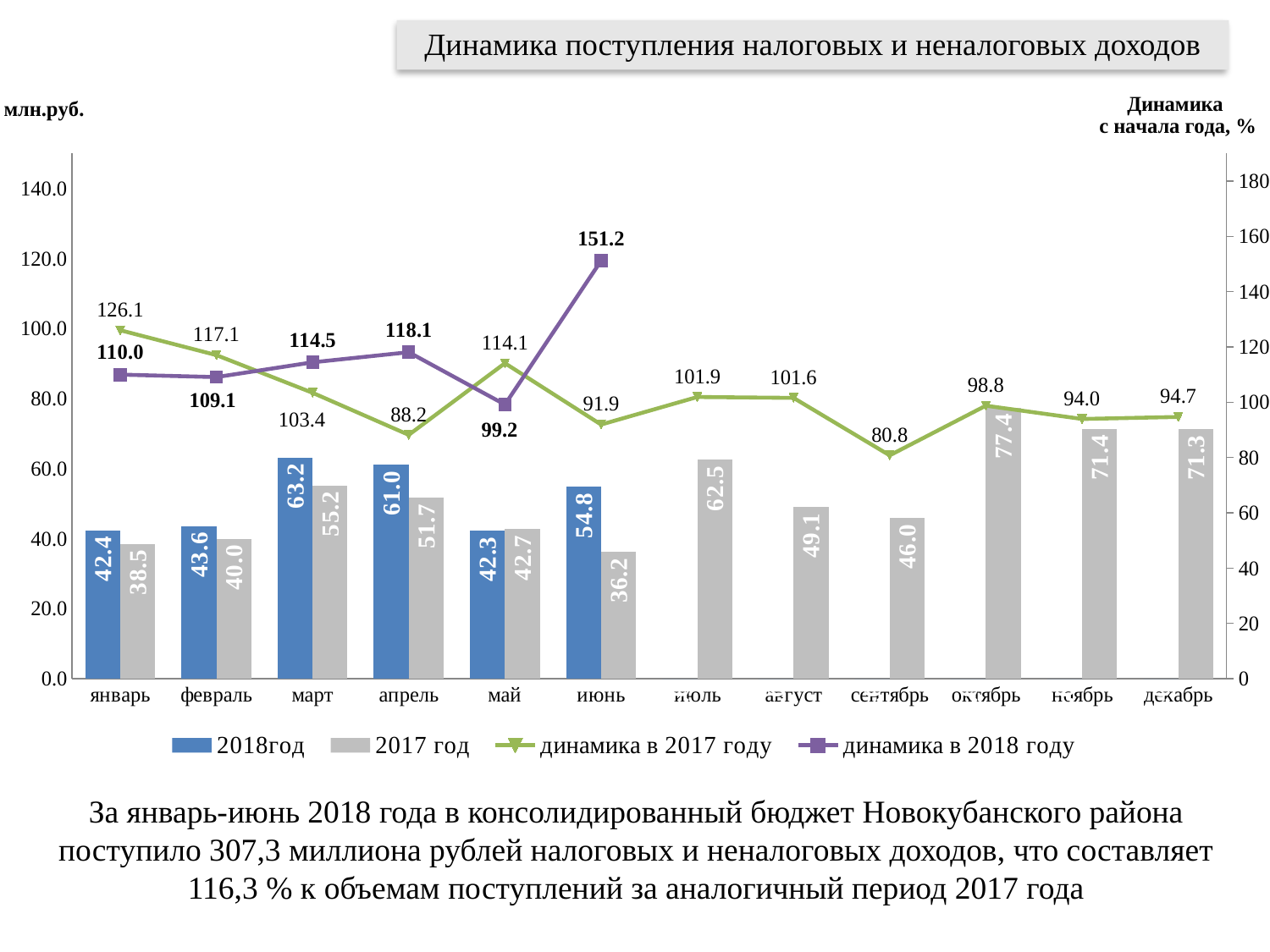
What is the value of the 2018 год bar for март? 63.2 What is the difference between the 2018 год and 2017 год bars for март? 8.0 How many series does the legend list? 4 Which month has the lowest 2017 год bar? июнь What is the value of the 2017 год bar for октябрь? 77.4 Which month has the highest 2018 год bar? март What is the value of the динамика в 2018 году line for июнь? 151.2 For май, which bar is larger: 2018 год or 2017 год? 2017 год In which month is the динамика в 2017 году line at its lowest? сентябрь What kind of chart is shown on the slide? Combined bar and line chart How many months are shown on the x axis? 12 What is the title of the chart? Динамика поступления налоговых и неналоговых доходов